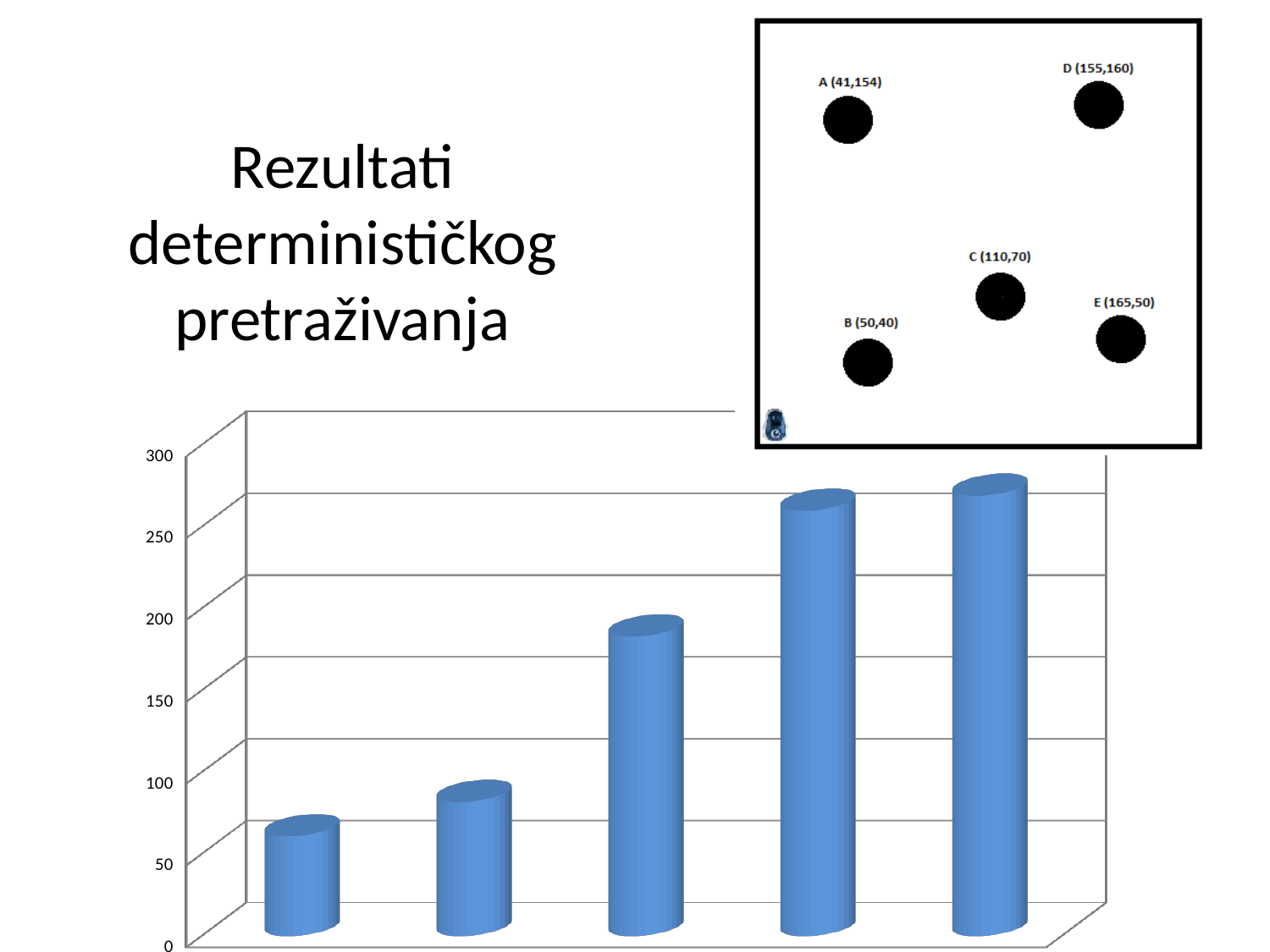
Which bar is the lowest in the bar chart? the first bar What is the highest value shown on the vertical axis of the bar chart? 300 Is the value of the fifth bar greater or less than 250? greater What kind of chart is shown at the bottom of the slide? bar chart What colour are the bars in the bar chart? blue Is the value of the first bar greater or less than 50? greater Which is larger, the value of the fourth bar or the value of the first bar? the fourth bar Is the value of the fourth bar greater or less than 250? greater Do the bar values rise or fall from left to right along the x axis? rise How many bars does the bar chart contain? 5